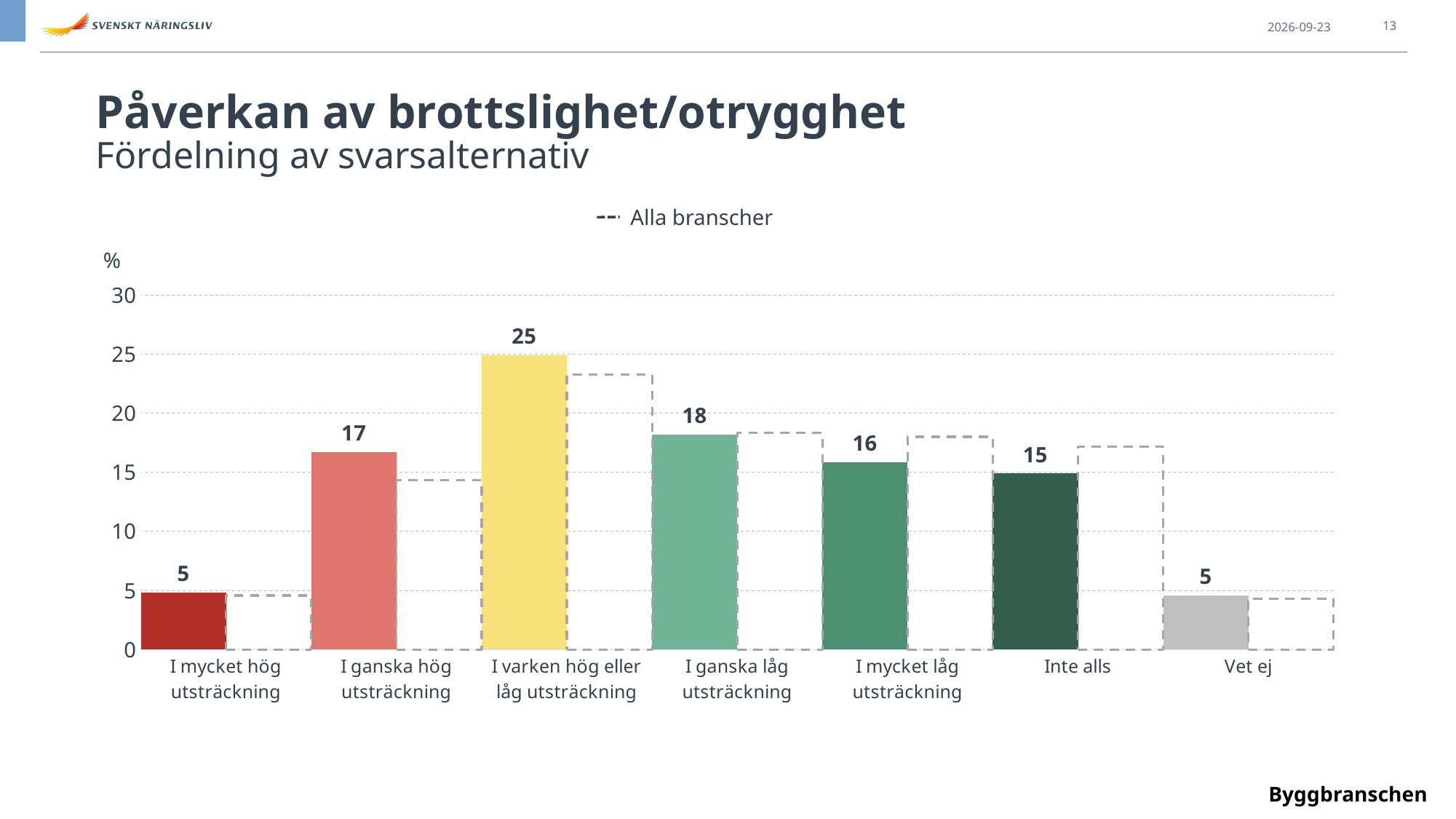
What is the value for "I varken hög eller låg utsträckning"? 25 What is the difference between the values for "I ganska låg utsträckning" and "I mycket låg utsträckning"? 2 Which category has the highest value? I varken hög eller låg utsträckning Which is larger, the value for "I ganska låg utsträckning" or the value for "Inte alls"? I ganska låg utsträckning What is the title of the chart on the slide? Påverkan av brottslighet/otrygghet Is the dashed "Alla branscher" value for "I varken hög eller låg utsträckning" greater or less than 20? greater How many categories are shown on the x axis? 7 What is the difference between the values for "I varken hög eller låg utsträckning" and "I ganska hög utsträckning"? 8 What is the value for "Inte alls"? 15 What entry does the legend list? Alla branscher What is the value for "I ganska hög utsträckning"? 17 What kind of chart is shown on the slide? bar chart